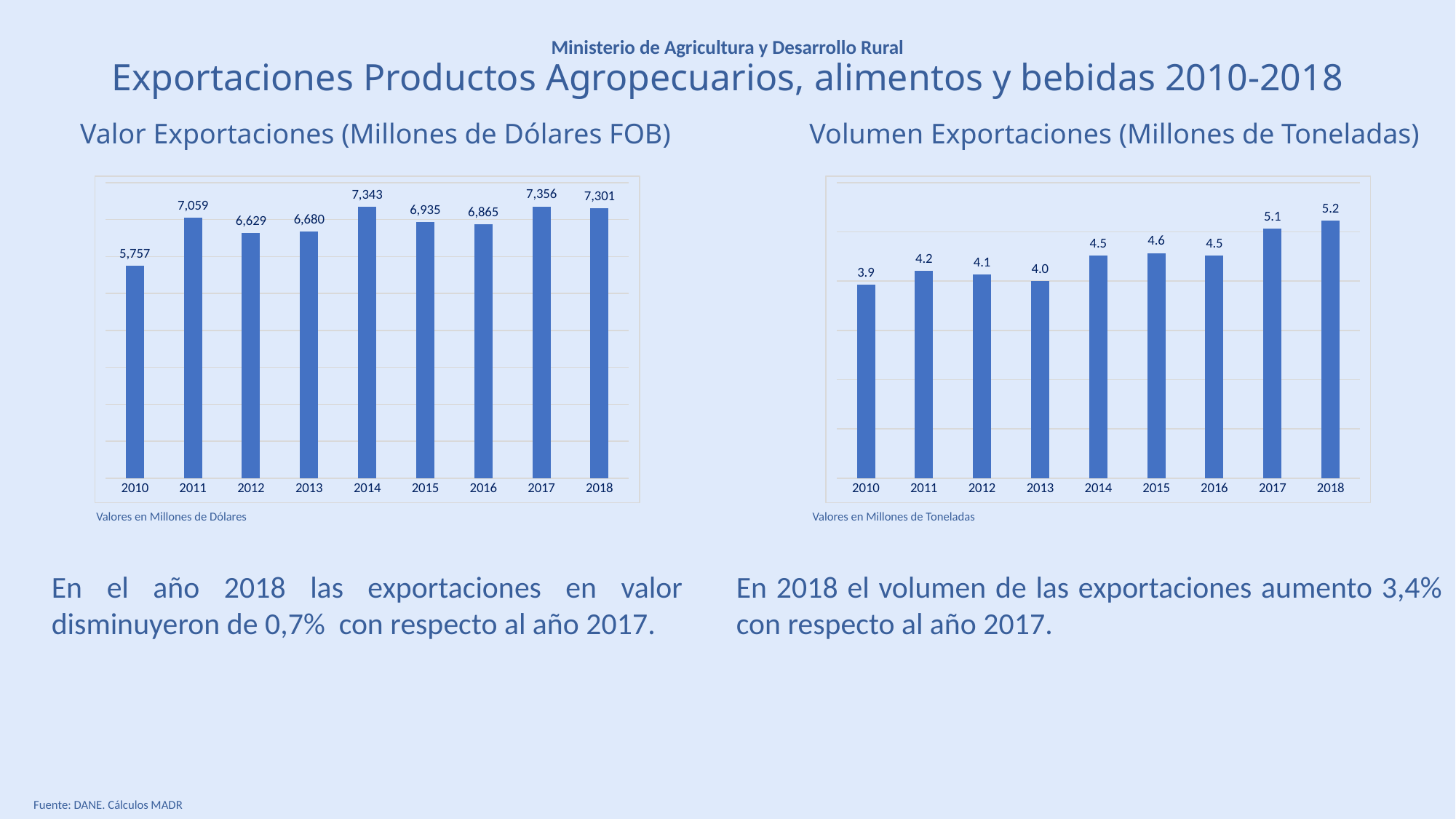
In the 'Valor Exportaciones (Millones de Dólares FOB)' chart, how many years are shown on the x axis? 9 In the 'Volumen Exportaciones (Millones de Toneladas)' chart, what is the difference between the values for 2018 and 2010? 1.3 In the 'Volumen Exportaciones (Millones de Toneladas)' chart, do the values generally rise or fall from 2010 to 2018? Rise In the 'Volumen Exportaciones (Millones de Toneladas)' chart, what is the value for 2013? 4.0 In the 'Valor Exportaciones (Millones de Dólares FOB)' chart, which is larger, the value for 2012 or the value for 2013? 2013 What kind of chart is the 'Volumen Exportaciones (Millones de Toneladas)' chart? Bar chart In the 'Valor Exportaciones (Millones de Dólares FOB)' chart, what is the value for 2014? 7,343 In the 'Valor Exportaciones (Millones de Dólares FOB)' chart, which year has the lowest value? 2010 In the 'Volumen Exportaciones (Millones de Toneladas)' chart, what is the value for 2018? 5.2 In the 'Valor Exportaciones (Millones de Dólares FOB)' chart, which year has the highest value? 2017 In the 'Volumen Exportaciones (Millones de Toneladas)' chart, which year has the lowest value? 2010 In the 'Valor Exportaciones (Millones de Dólares FOB)' chart, what is the difference between the values for 2011 and 2010? 1,302